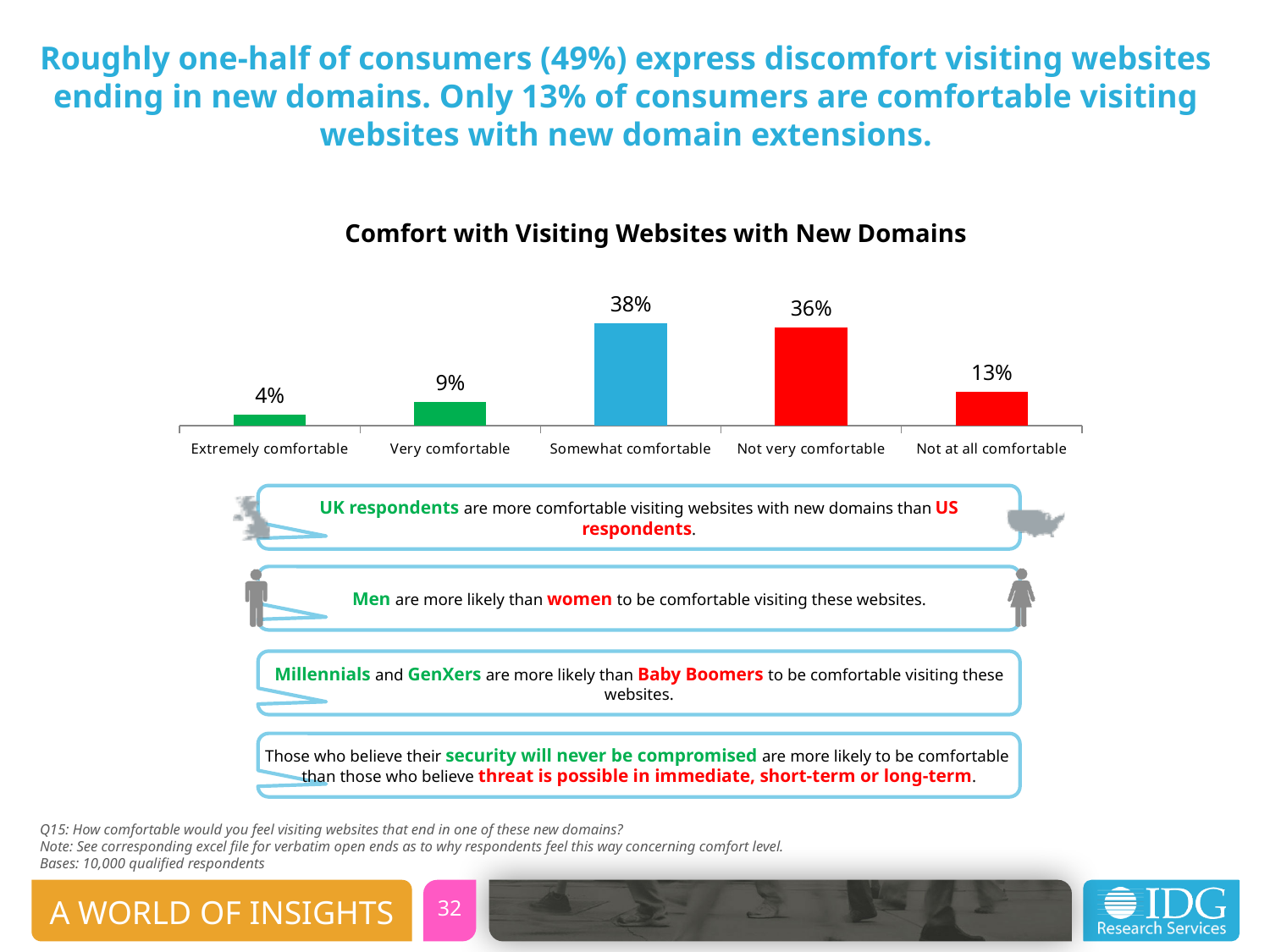
Which is larger, Very comfortable or Not at all comfortable? Not at all comfortable What is the title of the chart? Comfort with Visiting Websites with New Domains What is the value for Not at all comfortable? 13% What kind of chart is shown on the slide? Bar chart What is the value for Somewhat comfortable? 38% What colour is the bar for Somewhat comfortable? Blue What is the value for Extremely comfortable? 4% What is the combined value of Extremely comfortable and Very comfortable? 13% How many categories are shown in the chart? 5 Which category has the lowest value? Extremely comfortable What is the difference between Not very comfortable and Not at all comfortable? 23% Which category has the highest value? Somewhat comfortable